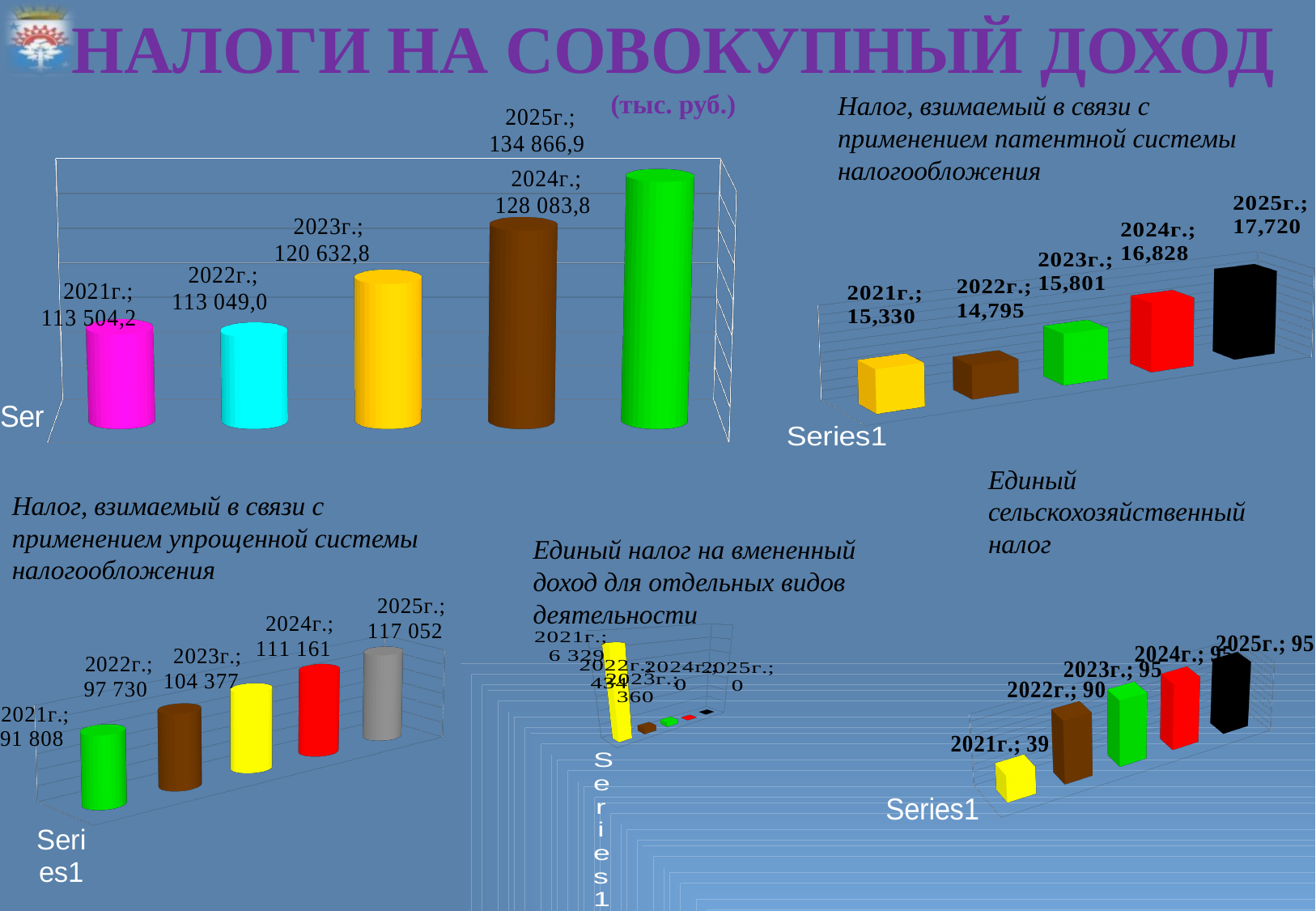
In the top-left chart (тыс. руб.), what is the value for 2025г.? 134 866,9 In the chart titled 'Единый сельскохозяйственный налог', what is the value for 2022г.? 90 In the chart titled 'Налог, взимаемый в связи с применением патентной системы налогообложения', which is larger: the value for 2021г. or 2022г.? 2021г. In the chart titled 'Налог, взимаемый в связи с применением патентной системы налогообложения', which year has the highest value? 2025г. In the chart titled 'Единый налог на вмененный доход для отдельных видов деятельности', what is the value for 2021г.? 6 329 In the chart titled 'Налог, взимаемый в связи с применением упрощенной системы налогообложения', how many years are plotted? 5 In the top-left chart (тыс. руб.), what is the difference between the 2025г. and 2024г. values? 6 783,1 In the chart titled 'Налог, взимаемый в связи с применением упрощенной системы налогообложения', do the values rise or fall from 2021г. to 2025г.? rise In the top-left chart (тыс. руб.), which year has the lowest value? 2022г. In the chart titled 'Единый сельскохозяйственный налог', what is the difference between the 2023г. and 2021г. values? 56 In the chart titled 'Налог, взимаемый в связи с применением упрощенной системы налогообложения', what is the value for 2021г.? 91 808 In the chart titled 'Налог, взимаемый в связи с применением патентной системы налогообложения', what is the value for 2023г.? 15,801